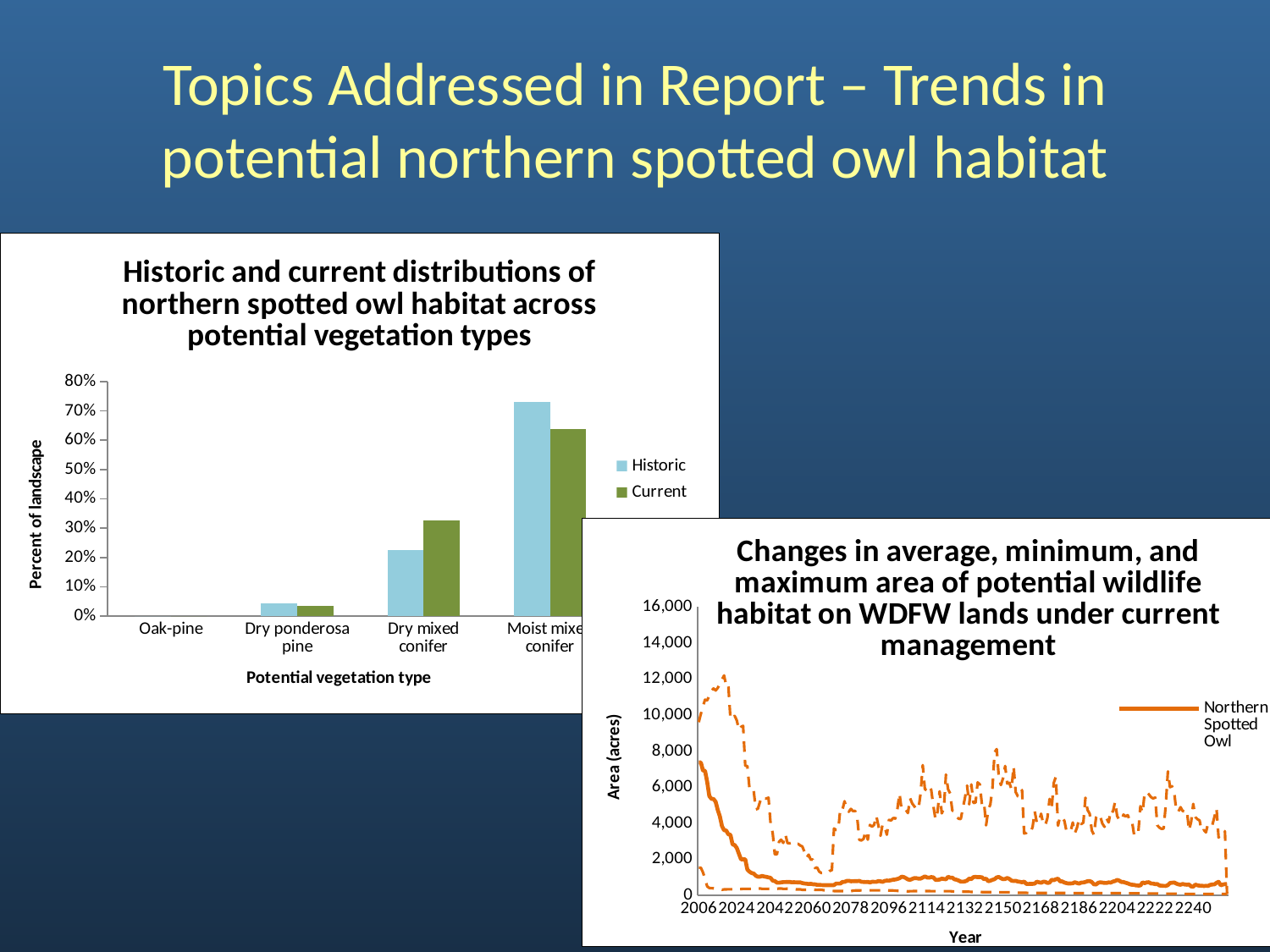
In the chart titled 'Historic and current distributions of northern spotted owl habitat across potential vegetation types', which vegetation type has the highest Historic value? Moist mixed conifer In the chart titled 'Changes in average, minimum, and maximum area of potential wildlife habitat on WDFW lands under current management', what kind of chart is shown? line chart In the chart titled 'Historic and current distributions of northern spotted owl habitat across potential vegetation types', what are the two series named in the legend? Historic and Current In the chart titled 'Historic and current distributions of northern spotted owl habitat across potential vegetation types', how many vegetation type categories are shown on the x axis? 4 In the chart titled 'Historic and current distributions of northern spotted owl habitat across potential vegetation types', how many series does the legend list? 2 In the chart titled 'Historic and current distributions of northern spotted owl habitat across potential vegetation types', for Moist mixed conifer, which is larger: the Historic or the Current value? Historic In the chart titled 'Historic and current distributions of northern spotted owl habitat across potential vegetation types', is the Current value for Dry mixed conifer greater or less than 30%? greater In the chart titled 'Historic and current distributions of northern spotted owl habitat across potential vegetation types', what kind of chart is shown? bar chart In the chart titled 'Changes in average, minimum, and maximum area of potential wildlife habitat on WDFW lands under current management', does the solid average line rise or fall between 2006 and 2042? fall In the chart titled 'Historic and current distributions of northern spotted owl habitat across potential vegetation types', is the Historic value for Dry mixed conifer greater or less than 30%? less In the chart titled 'Historic and current distributions of northern spotted owl habitat across potential vegetation types', for Dry mixed conifer, which is larger: the Historic or the Current value? Current In the chart titled 'Historic and current distributions of northern spotted owl habitat across potential vegetation types', what is the label of the y axis? Percent of landscape